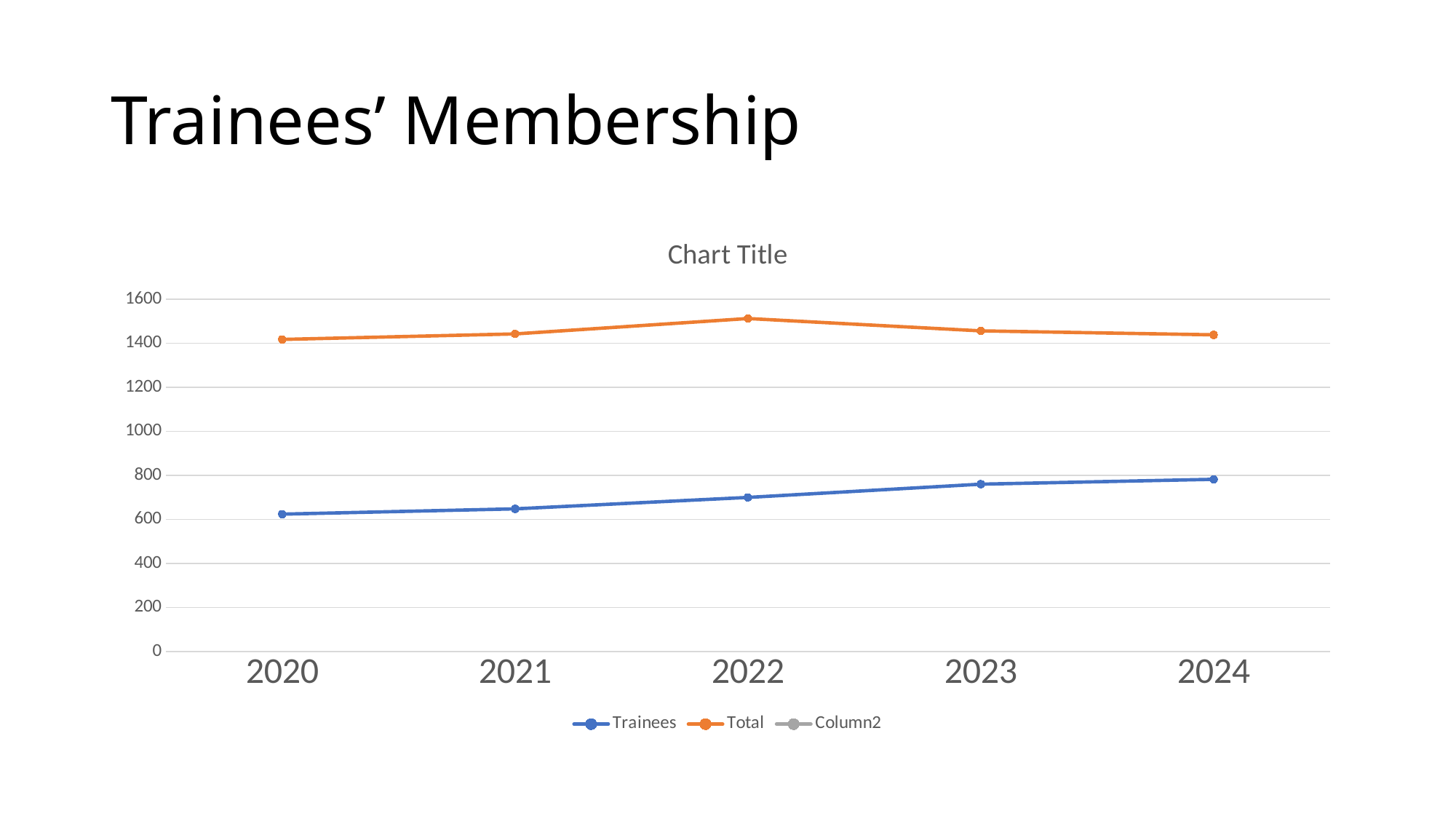
How many years are plotted along the x axis? 5 In which year is the Total series at its highest? 2022 Which is larger for Trainees, the 2020 value or the 2023 value? 2023 How many series does the legend list? 3 What kind of chart is shown on the slide? Line chart Which is larger in 2023, the Trainees value or the Total value? Total Is the value for Total in 2022 greater or less than 1400? greater Is the value for Total in 2022 greater or less than 1600? less Is the value for Trainees in 2024 greater or less than 800? less Do the Trainees values rise or fall from 2020 to 2024? Rise What title is displayed above the chart? Chart Title